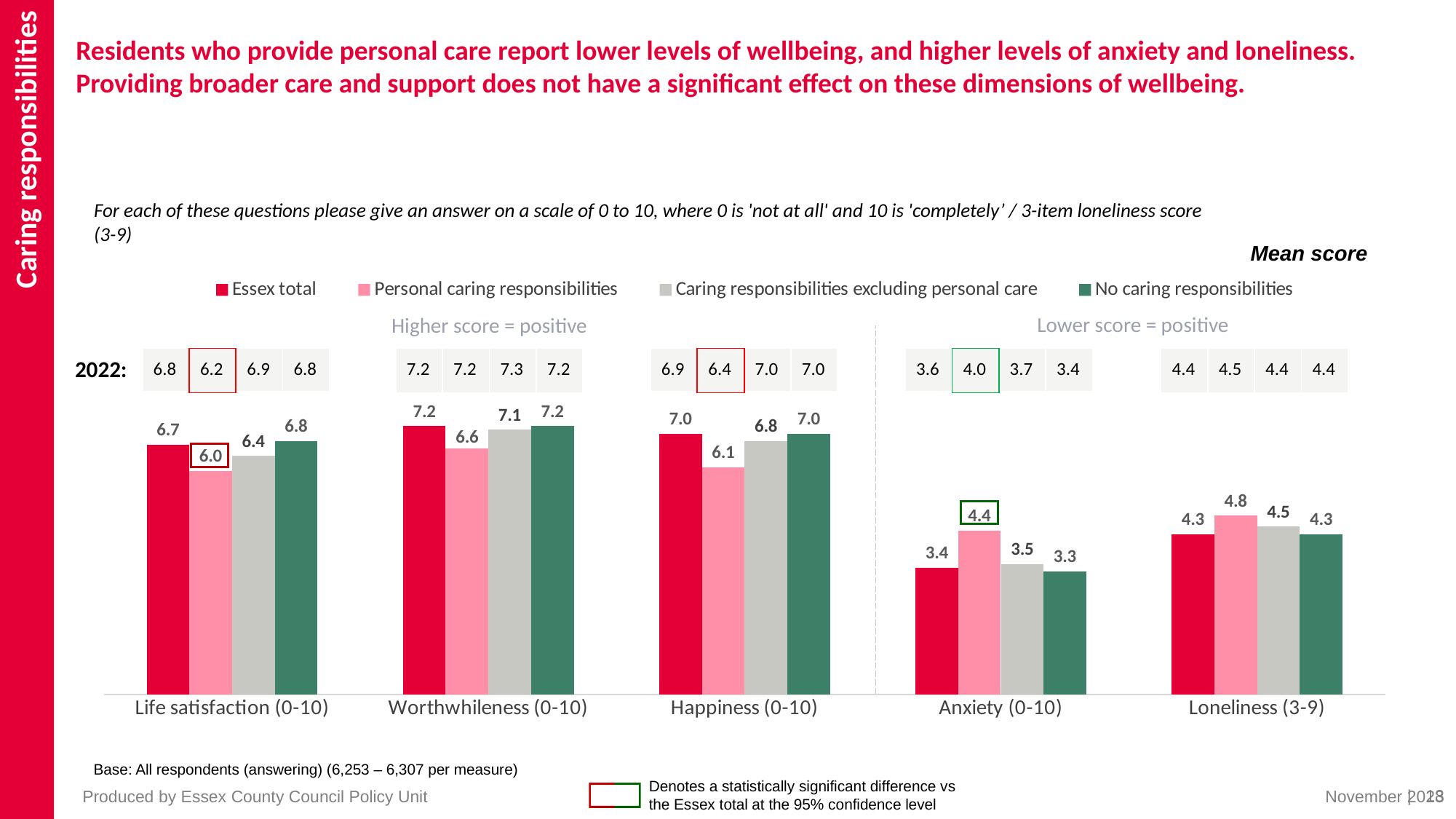
What is the mean Loneliness score for residents with personal caring responsibilities? 4.8 What is the mean Anxiety score for the Essex total? 3.4 In the 2022 row above the chart, what was the Anxiety score for residents with personal caring responsibilities? 4.0 Which is larger: the Loneliness score for caring responsibilities excluding personal care or for no caring responsibilities? Caring responsibilities excluding personal care Which group has the lowest mean Worthwhileness score? Personal caring responsibilities How many series does the chart legend list? 4 What kind of chart is shown on the slide? Bar chart What is the difference between the Happiness scores for the Essex total and for residents with personal caring responsibilities? 0.9 What is the mean Life satisfaction score for residents with personal caring responsibilities? 6.0 What is the mean Happiness score for residents with no caring responsibilities? 7.0 How many measures (categories) are shown along the x axis of the chart? 5 Which group has the highest mean Anxiety score? Personal caring responsibilities